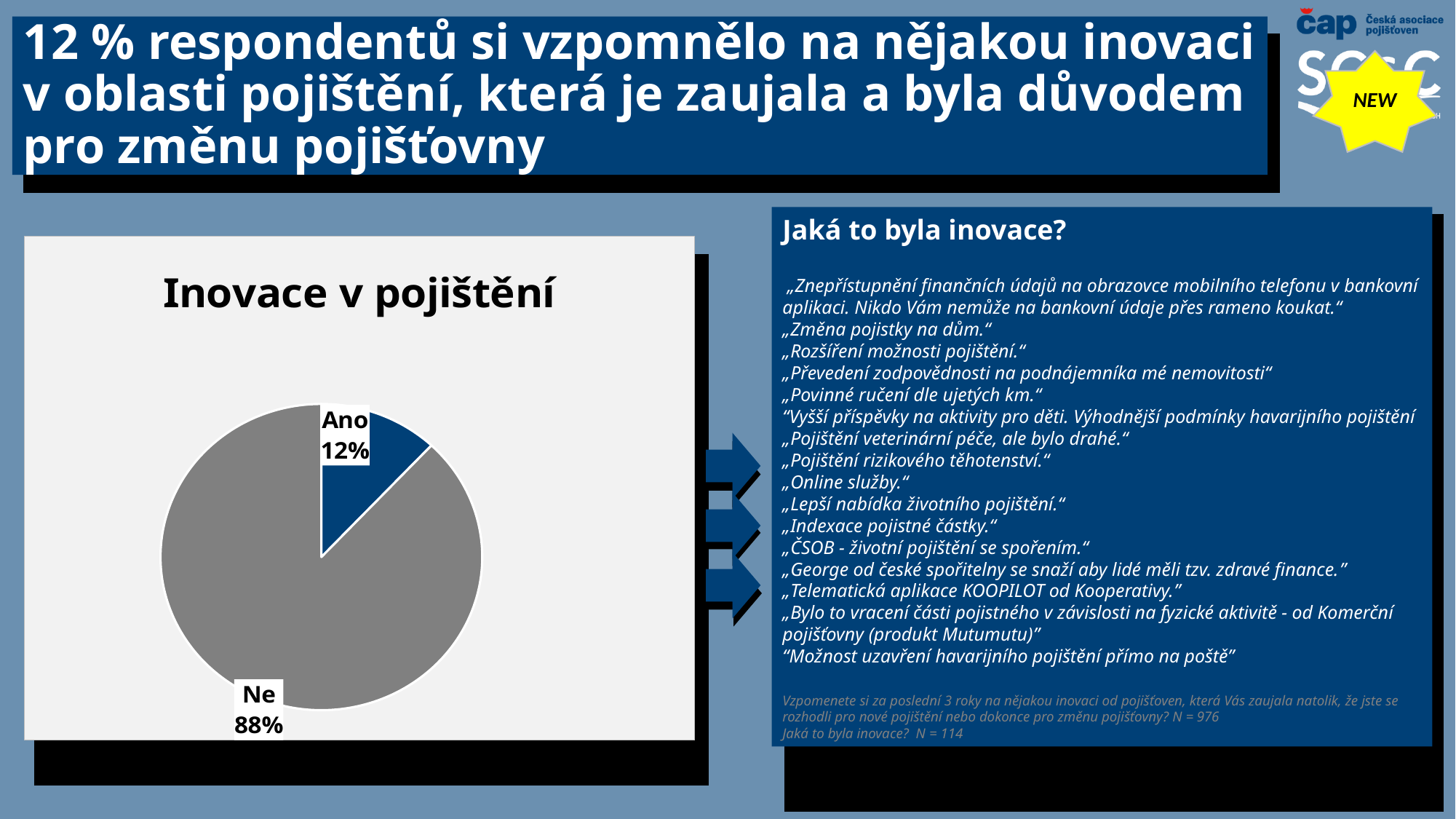
Which slice of the pie is the largest? Ne What share of the pie does the "Ne" slice represent? 88% Which slice of the pie is the smallest? Ano What colour is the "Ano" slice of the pie? dark blue How many slices does the pie chart have? 2 What kind of chart is shown on the slide? pie chart Which is larger, the "Ano" slice or the "Ne" slice? Ne What is the difference in percentage points between the "Ne" and "Ano" slices? 76 What is the title of the chart? Inovace v pojištění What share of the pie does the "Ano" slice represent? 12% What is the total of the two slices shown in the pie chart? 100%